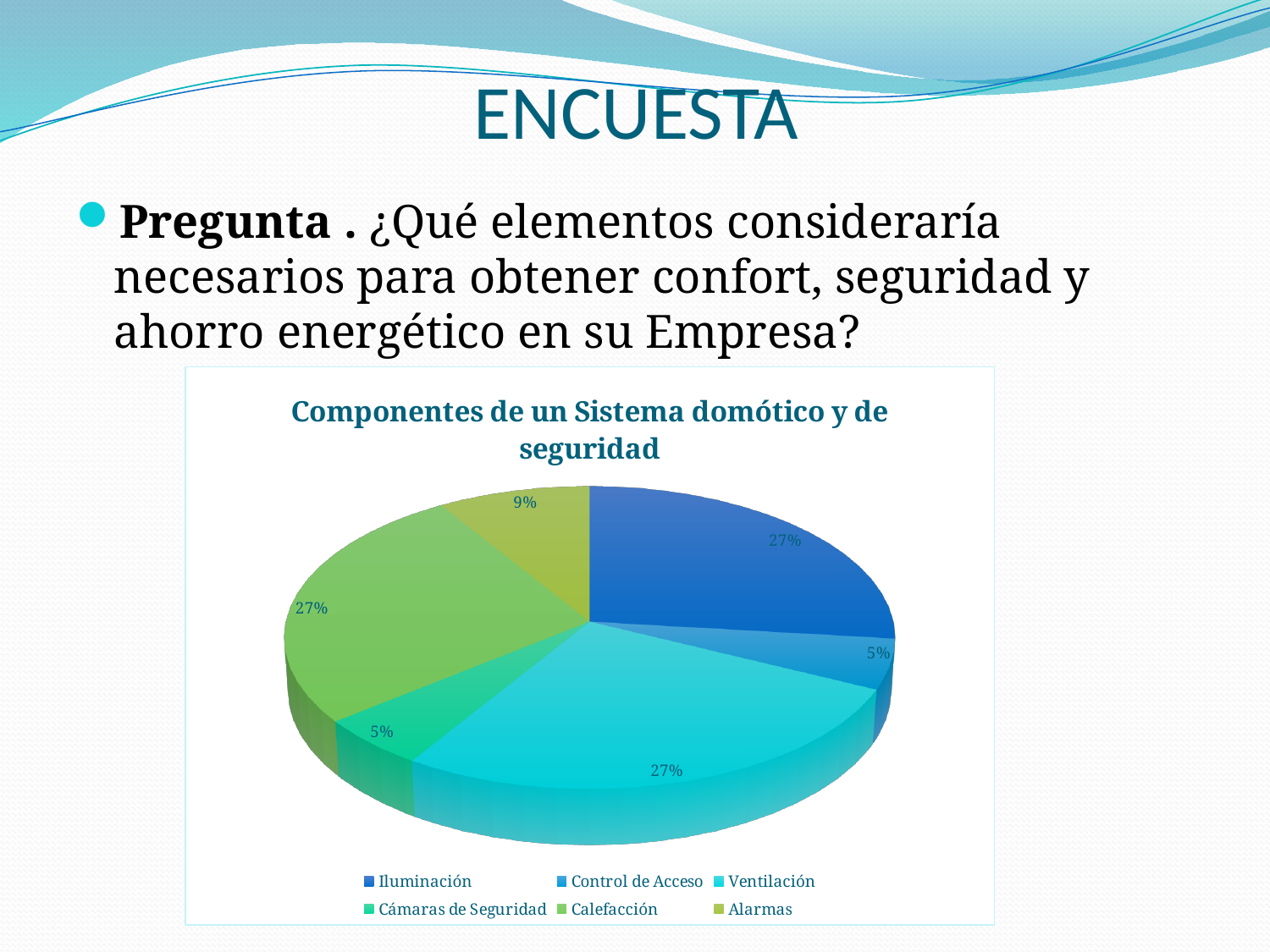
What is the difference in percentage points between the share for Iluminación and the share for Alarmas? 18 Which legend entry is listed first in the chart legend? Iluminación What share of the pie does Calefacción represent? 27% What share of the pie does Control de Acceso represent? 5% How many categories does the pie chart show? 6 What share of the pie does Iluminación represent? 27% What is the title of the chart? Componentes de un Sistema domótico y de seguridad What type of chart is shown on the slide? Pie chart Which is larger, the share for Alarmas or the share for Control de Acceso? Alarmas